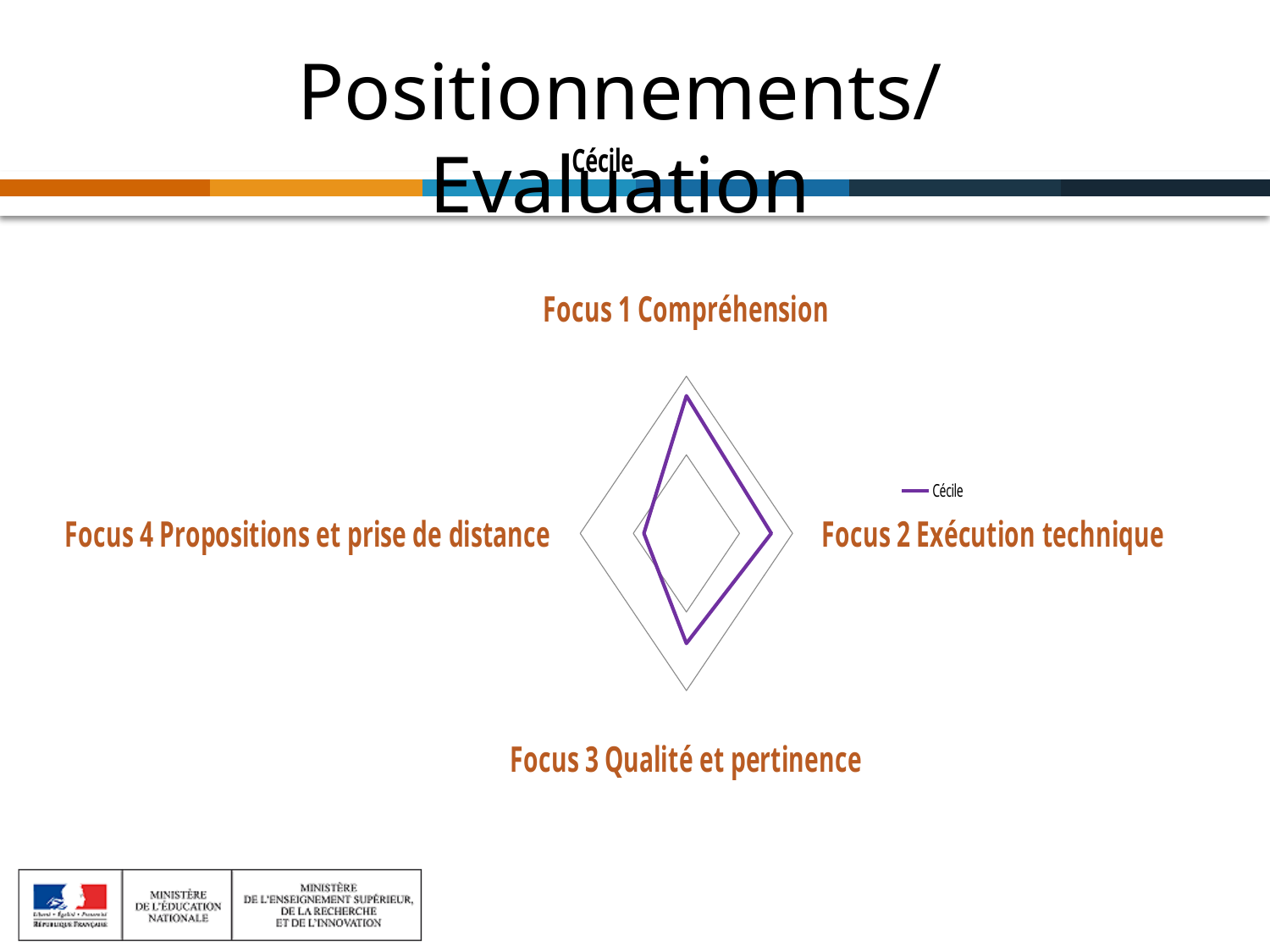
Which is larger in the radar chart: the value for Focus 1 Compréhension or for Focus 4 Propositions et prise de distance? Focus 1 Compréhension How many series does the legend of the radar chart list? 1 Which is larger in the radar chart: the value for Focus 2 Exécution technique or for Focus 4 Propositions et prise de distance? Focus 2 Exécution technique What is the name of the series shown in the legend of the radar chart? Cécile What kind of chart is shown on the slide? Radar chart Which category has the lowest value in the radar chart? Focus 4 Propositions et prise de distance Which category has the highest value in the radar chart? Focus 1 Compréhension Which is larger in the radar chart: the value for Focus 3 Qualité et pertinence or for Focus 4 Propositions et prise de distance? Focus 3 Qualité et pertinence What is the title of the radar chart? Cécile How many categories (axes) does the radar chart have? 4